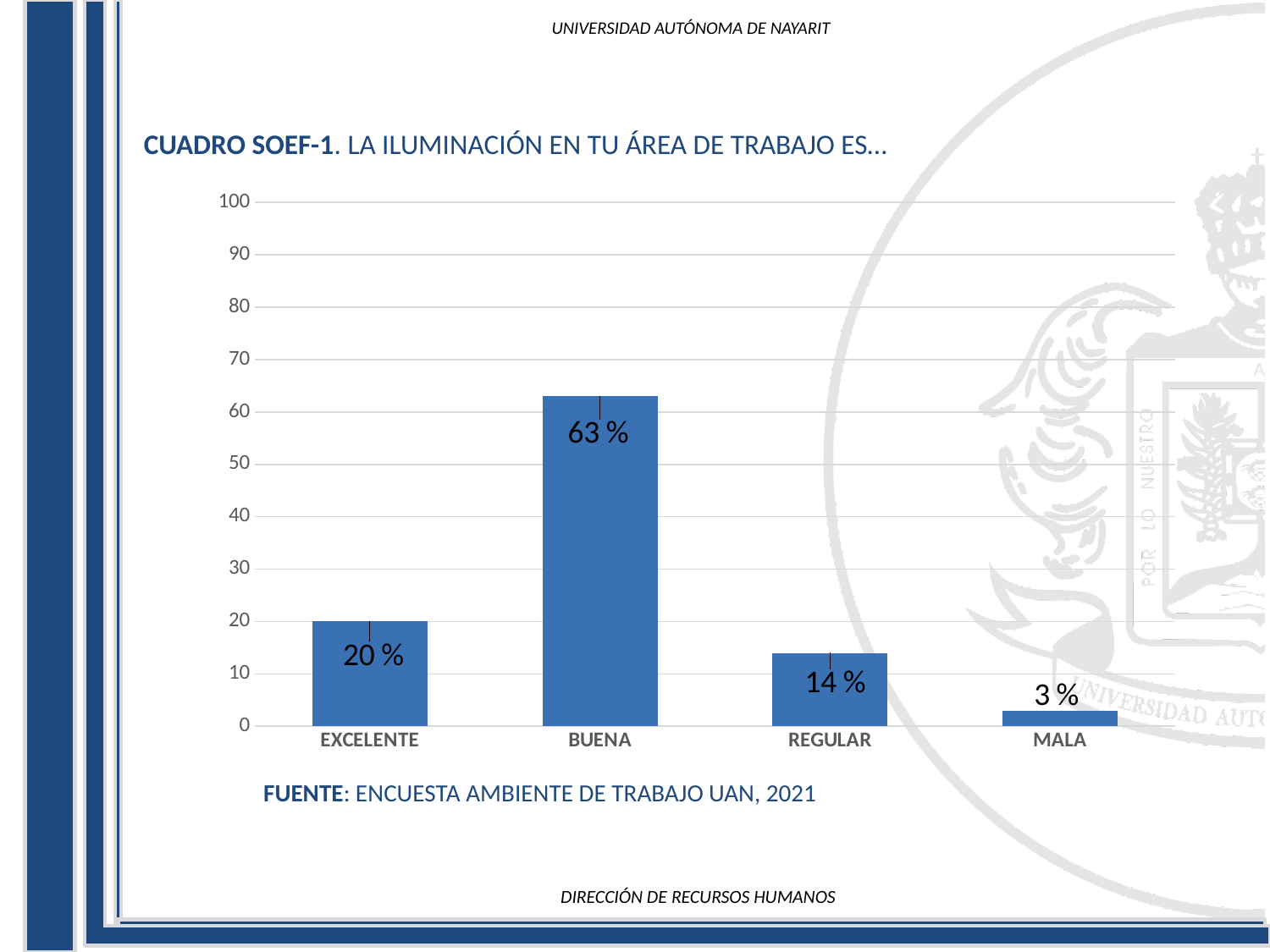
What is the value for REGULAR? 14 % Which category has the lowest value? MALA What is the value for MALA? 3 % How many categories are shown on the x axis? 4 Which is larger, the value for EXCELENTE or the value for REGULAR? EXCELENTE What source is cited below the chart? ENCUESTA AMBIENTE DE TRABAJO UAN, 2021 What is the difference between the values for BUENA and EXCELENTE? 43 % Which category has the highest value? BUENA What kind of chart is shown on the slide? bar chart What is the value for BUENA? 63 % What is the value for EXCELENTE? 20 % Is the value for BUENA greater or less than 50? greater